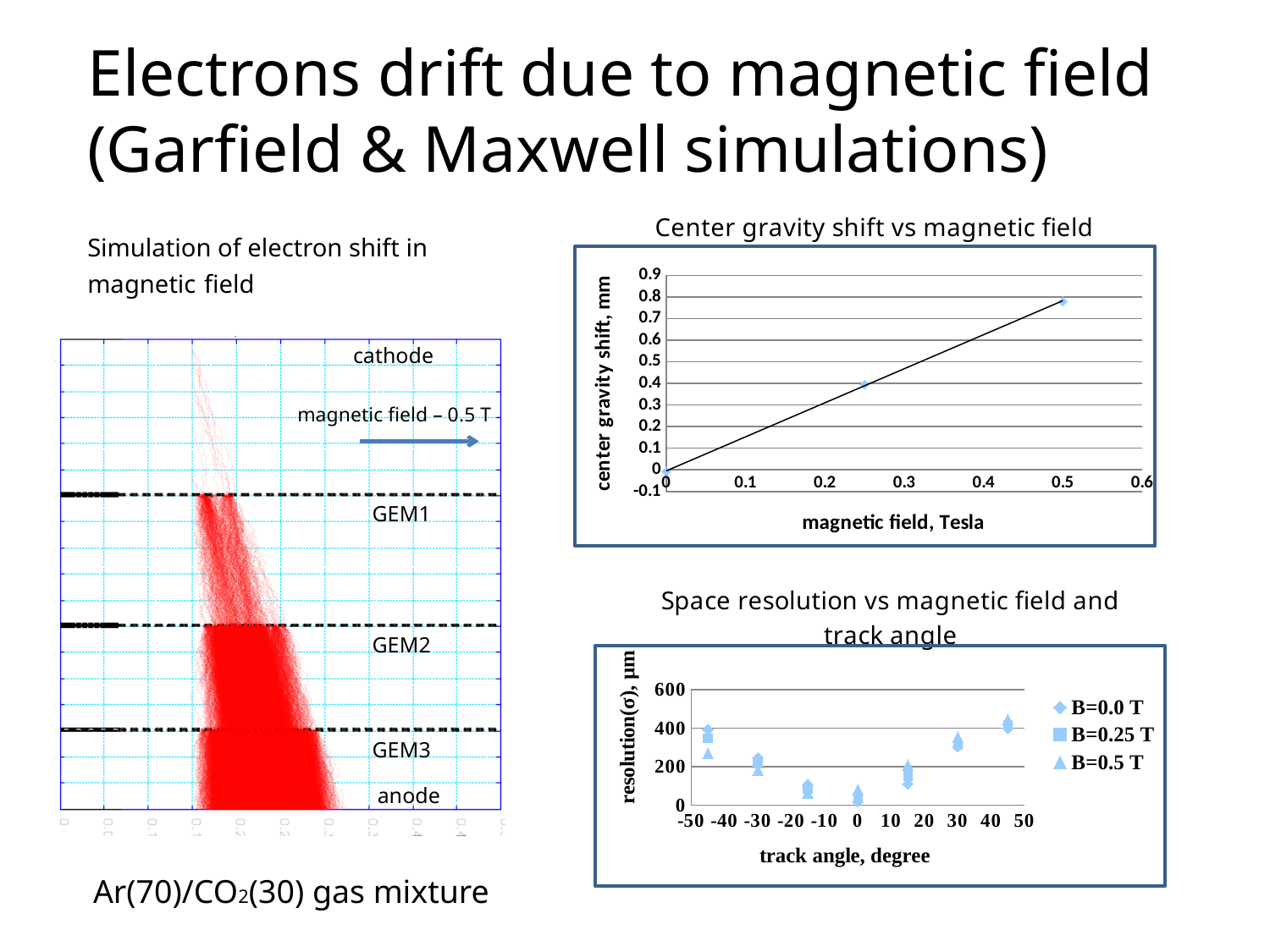
In the 'Center gravity shift vs magnetic field' chart, is the center gravity shift at 0.5 Tesla greater or less than 0.7 mm? greater In the 'Center gravity shift vs magnetic field' chart, is the center gravity shift at 0.25 Tesla greater or less than 0.3 mm? greater How many series does the legend list in the 'Space resolution vs magnetic field and track angle' chart? 3 In the 'Center gravity shift vs magnetic field' chart, at which magnetic field value is the center gravity shift highest? 0.5 Tesla In the 'Space resolution vs magnetic field and track angle' chart, at which track angle is the resolution lowest? 0 degrees In the 'Space resolution vs magnetic field and track angle' chart, is the B=0.0 T resolution at a track angle of -45 degrees greater or less than 300 µm? greater How many data points are plotted in the 'Center gravity shift vs magnetic field' chart? 3 What are the legend entries in the 'Space resolution vs magnetic field and track angle' chart? B=0.0 T, B=0.25 T, B=0.5 T What is the y-axis label of the 'Center gravity shift vs magnetic field' chart? center gravity shift, mm In the 'Space resolution vs magnetic field and track angle' chart, at a track angle of -45 degrees, which series has the larger resolution: B=0.0 T or B=0.5 T? B=0.0 T In the 'Center gravity shift vs magnetic field' chart, does the center gravity shift rise or fall as the magnetic field increases? rises